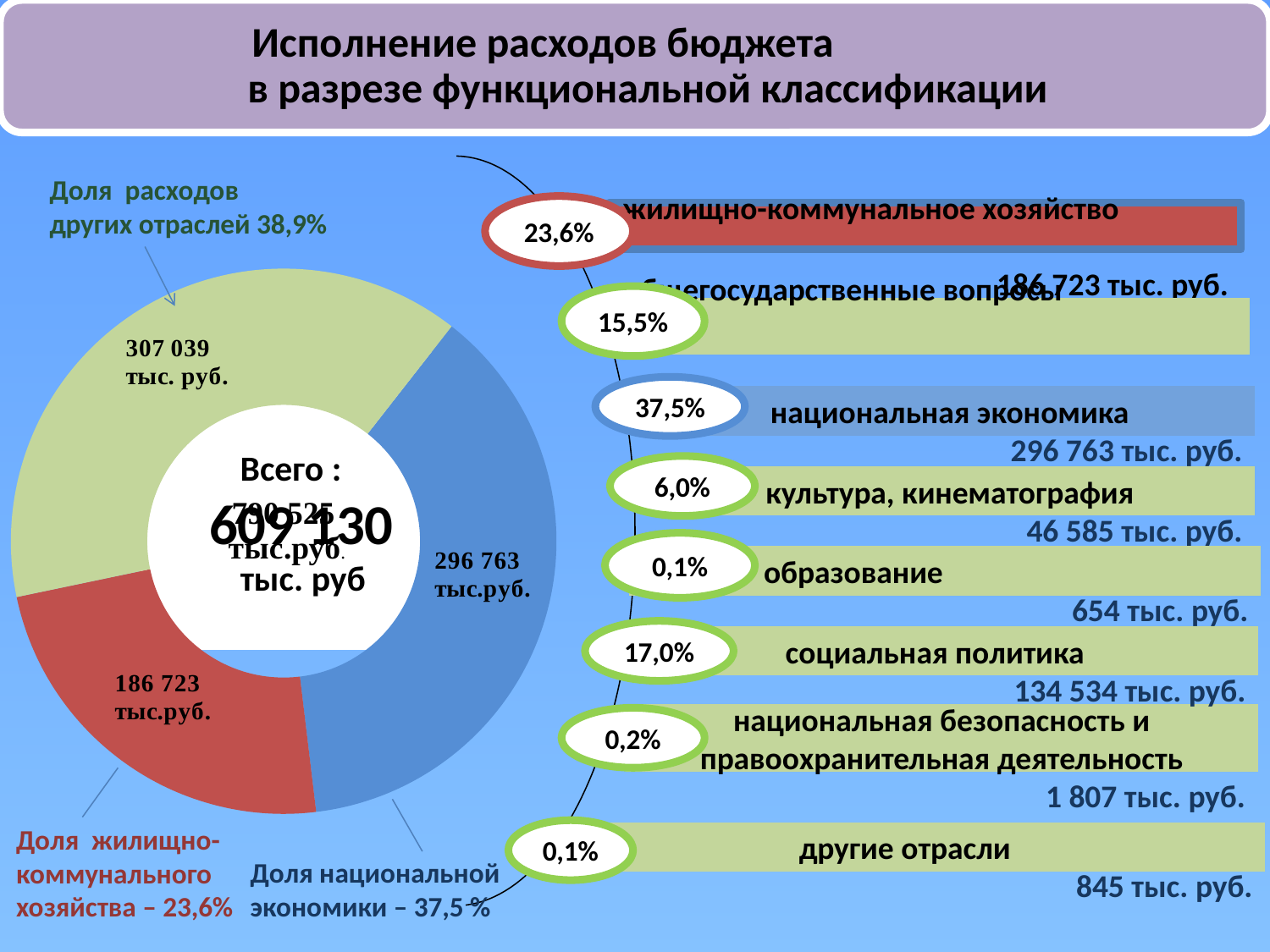
What colour is the slice for жилищно-коммунальное хозяйство in the doughnut chart? red In the doughnut chart, what share of expenditure is attributed to жилищно-коммунальное хозяйство? 23,6% How many slices does the doughnut chart on the left have? 3 In the doughnut chart, what is the value (in тыс. руб.) for жилищно-коммунальное хозяйство? 186 723 тыс. руб. Which slice of the doughnut chart is the smallest? жилищно-коммунальное хозяйство In the doughnut chart, what share of expenditure is attributed to другие отрасли? 38,9% In the doughnut chart, what is the value (in тыс. руб.) for другие отрасли? 307 039 тыс. руб. What kind of chart is shown on the left of the slide? doughnut (pie) chart In the doughnut chart, what share of expenditure is attributed to национальная экономика? 37,5% In the doughnut chart, which is larger: the value for национальная экономика or for жилищно-коммунальное хозяйство? национальная экономика In the doughnut chart, what is the difference between the value for другие отрасли and the value for жилищно-коммунальное хозяйство (in тыс. руб.)? 120 316 тыс. руб. In the doughnut chart, what is the value (in тыс. руб.) for национальная экономика? 296 763 тыс. руб.